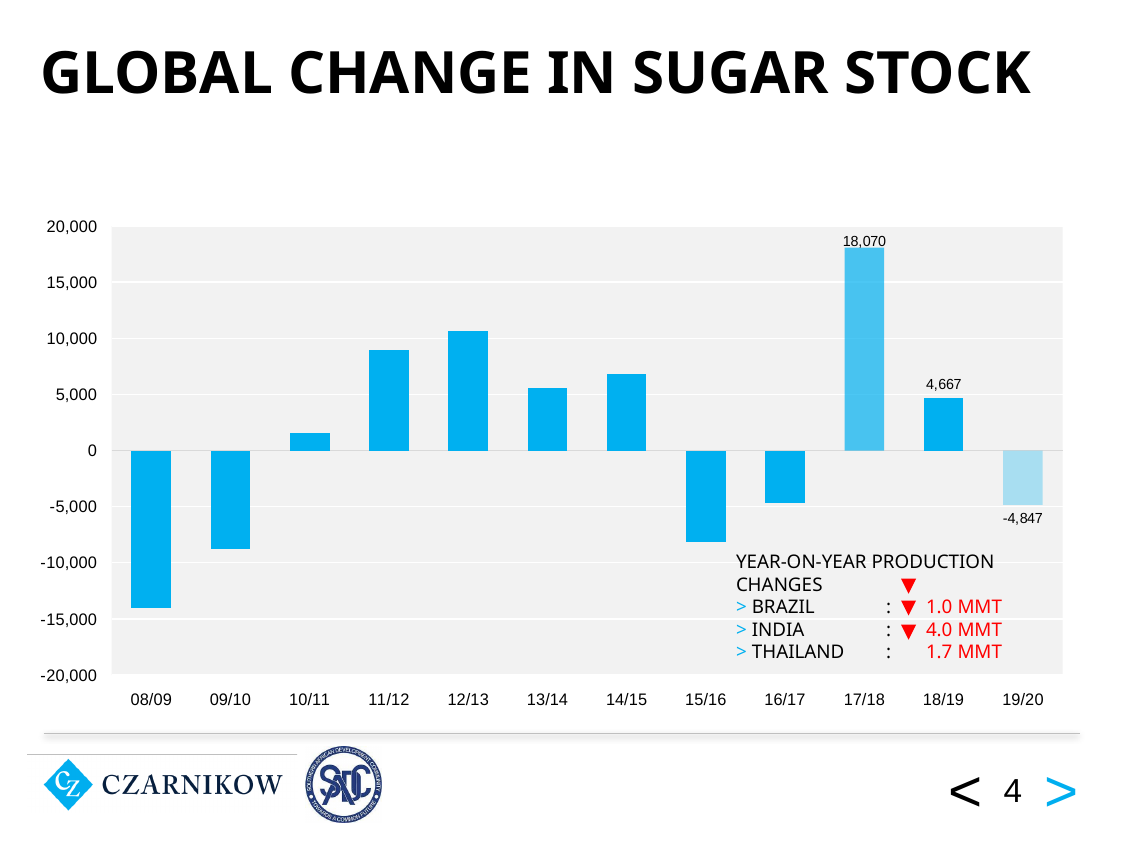
What is the value for 18/19? 4,667 Which year has the lowest value? 08/09 Is the value for 11/12 greater or less than 5,000? greater What is the difference between the values for 17/18 and 18/19? 13,403 Which is larger, the value for 18/19 or the value for 19/20? 18/19 What kind of chart is shown on the slide? bar chart Is the value for 15/16 greater or less than -5,000? less What is the value for 17/18? 18,070 Which year has the highest value? 17/18 How many years are shown on the x axis? 12 Is the value for 08/09 greater or less than -10,000? less What is the value for 19/20? -4,847